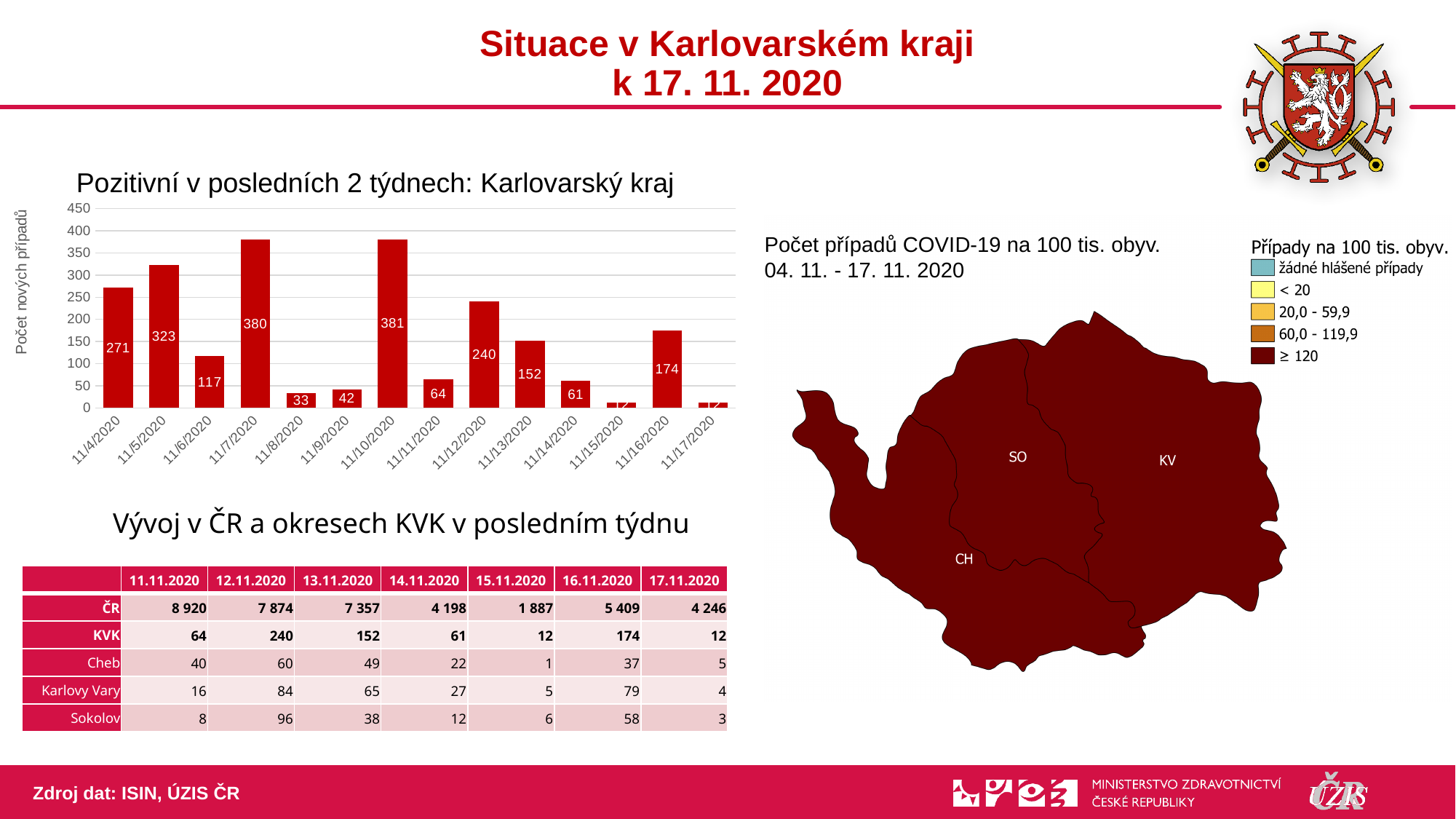
In the chart 'Pozitivní v posledních 2 týdnech: Karlovarský kraj', what is the difference between the values for 11/5/2020 and 11/6/2020? 206 In the chart 'Pozitivní v posledních 2 týdnech: Karlovarský kraj', what is the difference between the values for 11/10/2020 and 11/13/2020? 229 In the chart 'Pozitivní v posledních 2 týdnech: Karlovarský kraj', is the value for 11/8/2020 greater or less than 50? less In the chart 'Pozitivní v posledních 2 týdnech: Karlovarský kraj', what is the value for 11/7/2020? 380 How many dates are shown on the x axis of the chart 'Pozitivní v posledních 2 týdnech: Karlovarský kraj'? 14 In the chart 'Pozitivní v posledních 2 týdnech: Karlovarský kraj', do the values rise or fall from 11/12/2020 to 11/14/2020? fall What kind of chart is 'Pozitivní v posledních 2 týdnech: Karlovarský kraj'? bar chart In the chart 'Pozitivní v posledních 2 týdnech: Karlovarský kraj', what is the value for 11/4/2020? 271 What is the label of the y axis of the chart 'Pozitivní v posledních 2 týdnech: Karlovarský kraj'? Počet nových případů In the chart 'Pozitivní v posledních 2 týdnech: Karlovarský kraj', which has the larger value, 11/9/2020 or 11/11/2020? 11/11/2020 In the chart 'Pozitivní v posledních 2 týdnech: Karlovarský kraj', what is the value for 11/12/2020? 240 In the chart 'Pozitivní v posledních 2 týdnech: Karlovarský kraj', is the value for 11/16/2020 greater or less than 150? greater